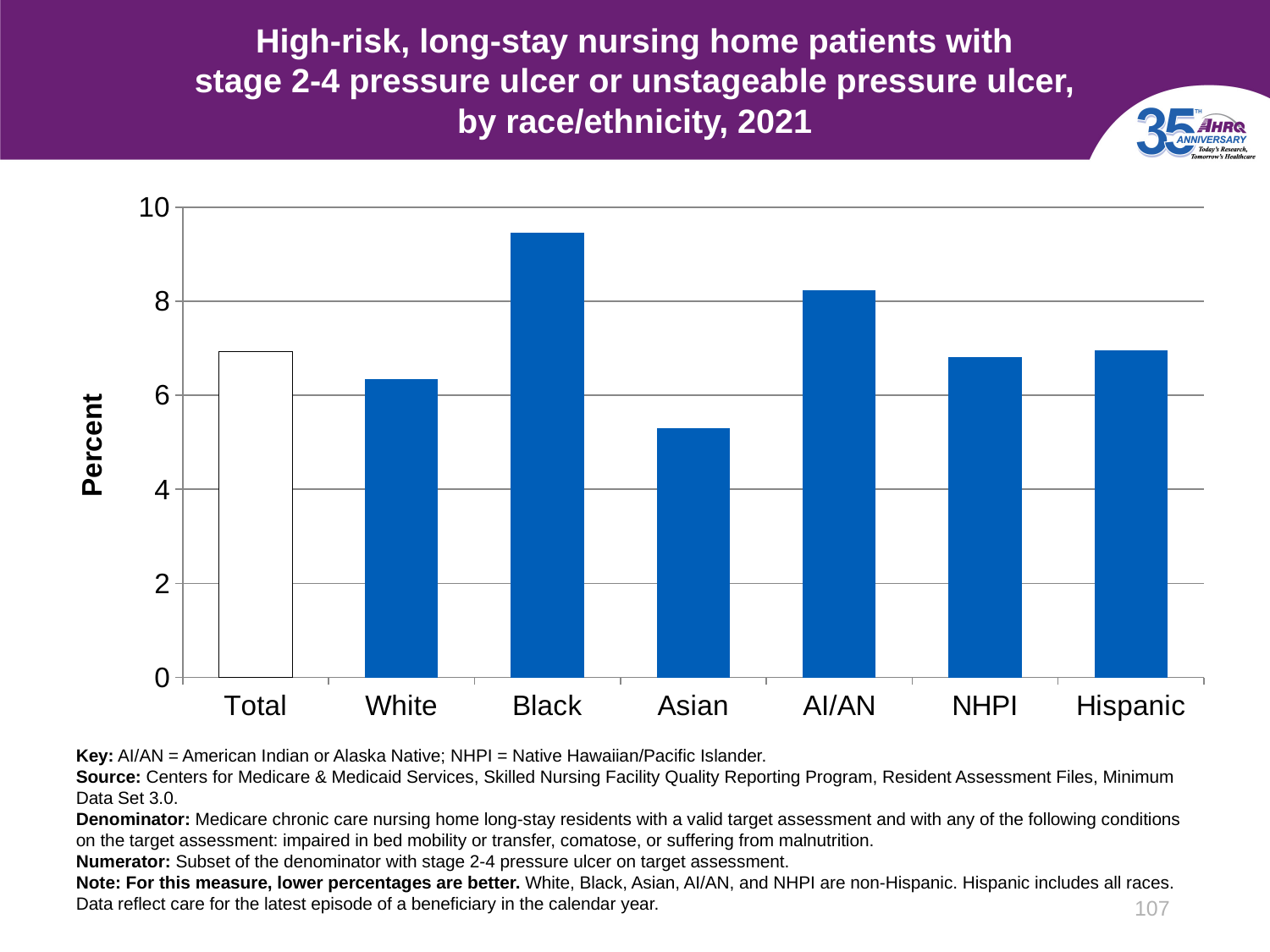
Which category has the highest percentage? Black Which is larger, the value for White or the value for Asian? White Which category has the lowest percentage? Asian Is the value for Asian greater or less than 6? less Is the value for Total greater or less than 8? less Is the value for Black greater or less than 8? greater Which is larger, the value for Black or the value for AI/AN? Black What is the label on the vertical axis of the chart? Percent What kind of chart is shown on the slide? bar chart Which is larger, the value for AI/AN or the value for NHPI? AI/AN How many race/ethnicity categories are plotted on the chart? 7